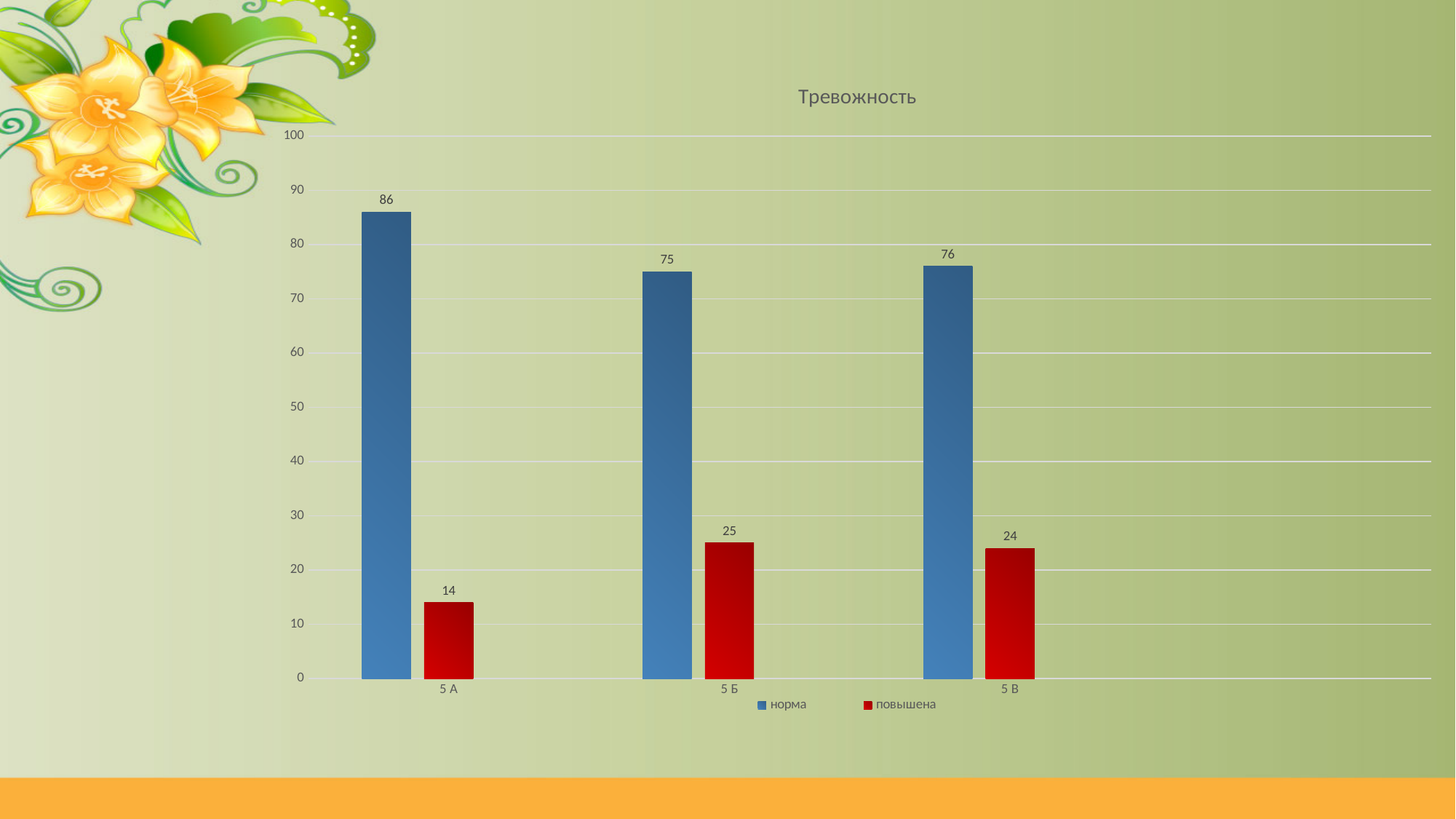
Which is larger for 5 Б: норма or повышена? норма What is the value of повышена for 5 В? 24 What kind of chart is shown on the slide? bar chart What is the difference between норма and повышена for 5 А? 72 What is the value of повышена for 5 Б? 25 What is the value of норма for 5 А? 86 What is the difference between the норма values for 5 А and 5 Б? 11 Which category has the lowest повышена value? 5 А What is the title of the chart? Тревожность How many categories are shown on the x axis? 3 Which category has the highest норма value? 5 А How many series does the legend list? 2